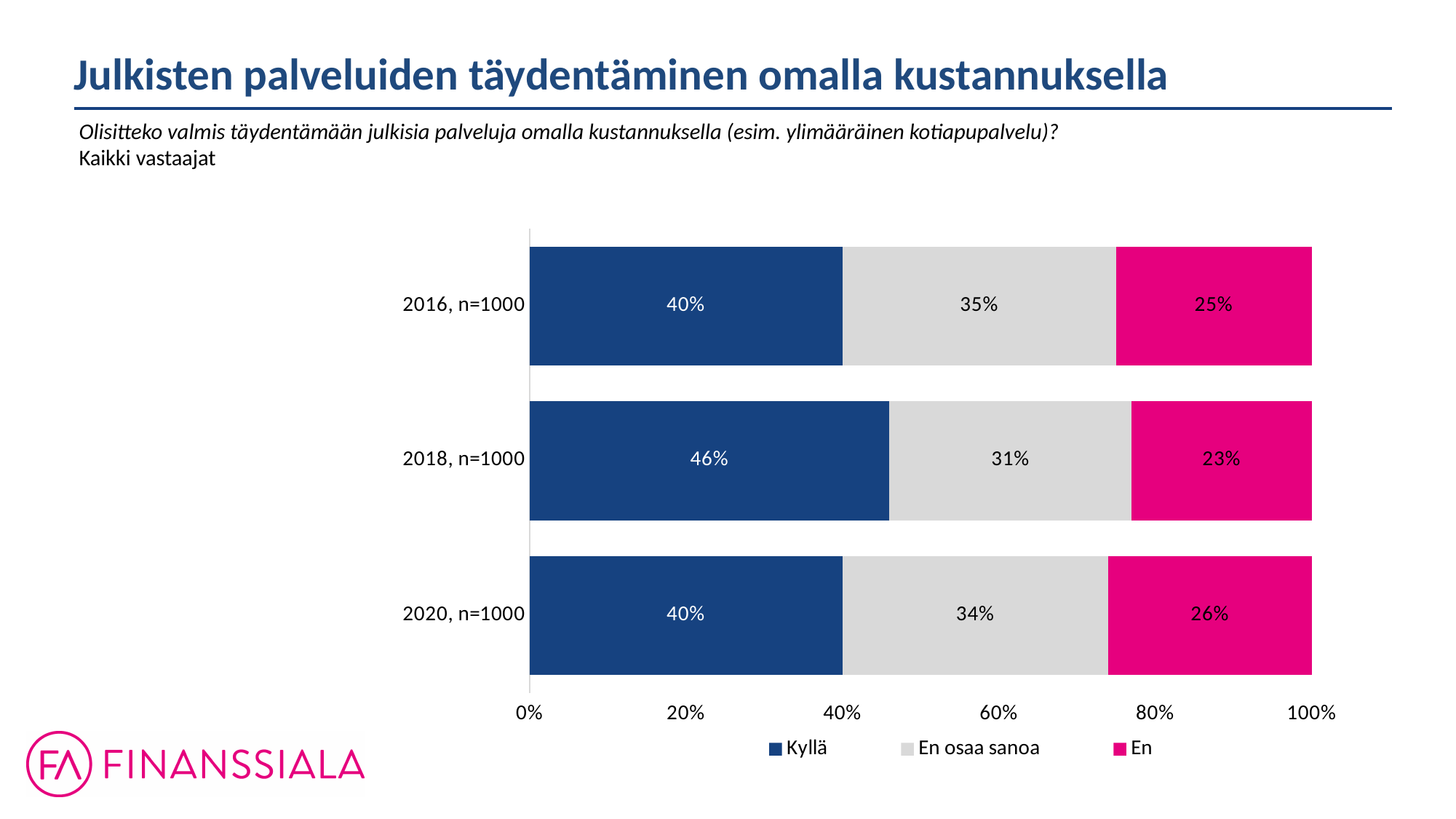
How many series does the legend list? 3 What is the value for En in 2020, n=1000? 26% Which year has the lowest value for En? 2018, n=1000 How many categories (years) are shown on the chart? 3 What kind of chart is shown on the slide? Stacked bar chart What is the value for Kyllä in 2018, n=1000? 46% What is the total of the stacked bar for 2020, n=1000? 100% What is the value for En osaa sanoa in 2016, n=1000? 35% Which is larger: En osaa sanoa in 2016 or En osaa sanoa in 2020? En osaa sanoa in 2016 Which year has the highest value for Kyllä? 2018, n=1000 Which legend entry is shown in pink? En What is the difference between the Kyllä value in 2018 and the Kyllä value in 2016? 6%